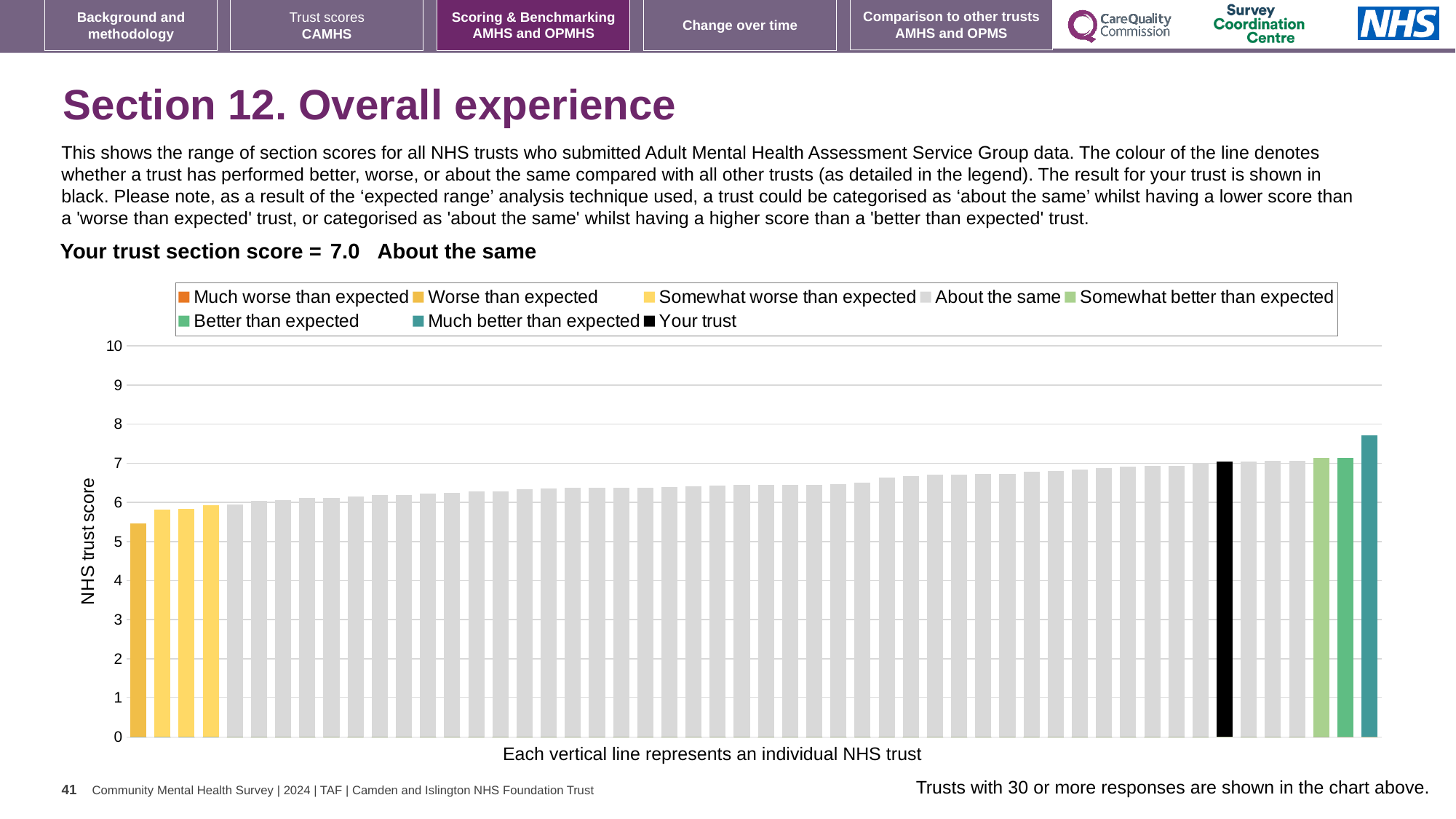
Which legend category does the highest bar in the chart belong to? Much better than expected Which category does your trust fall into according to the slide? About the same Which legend category does the lowest bar in the chart belong to? Worse than expected How many entries does the chart legend list? 8 Is the value of the lowest bar in the chart greater or less than 6? less What is the section score for your trust shown on the slide? 7.0 Is the value of the highest bar in the chart greater or less than 7? greater Is the value of the black 'Your trust' bar greater or less than 6? greater Do the bar values rise or fall from left to right along the x axis? rise What is the label on the vertical axis of the chart? NHS trust score How many bars are coloured as 'Worse than expected'? 1 What kind of chart is shown on the slide? bar chart